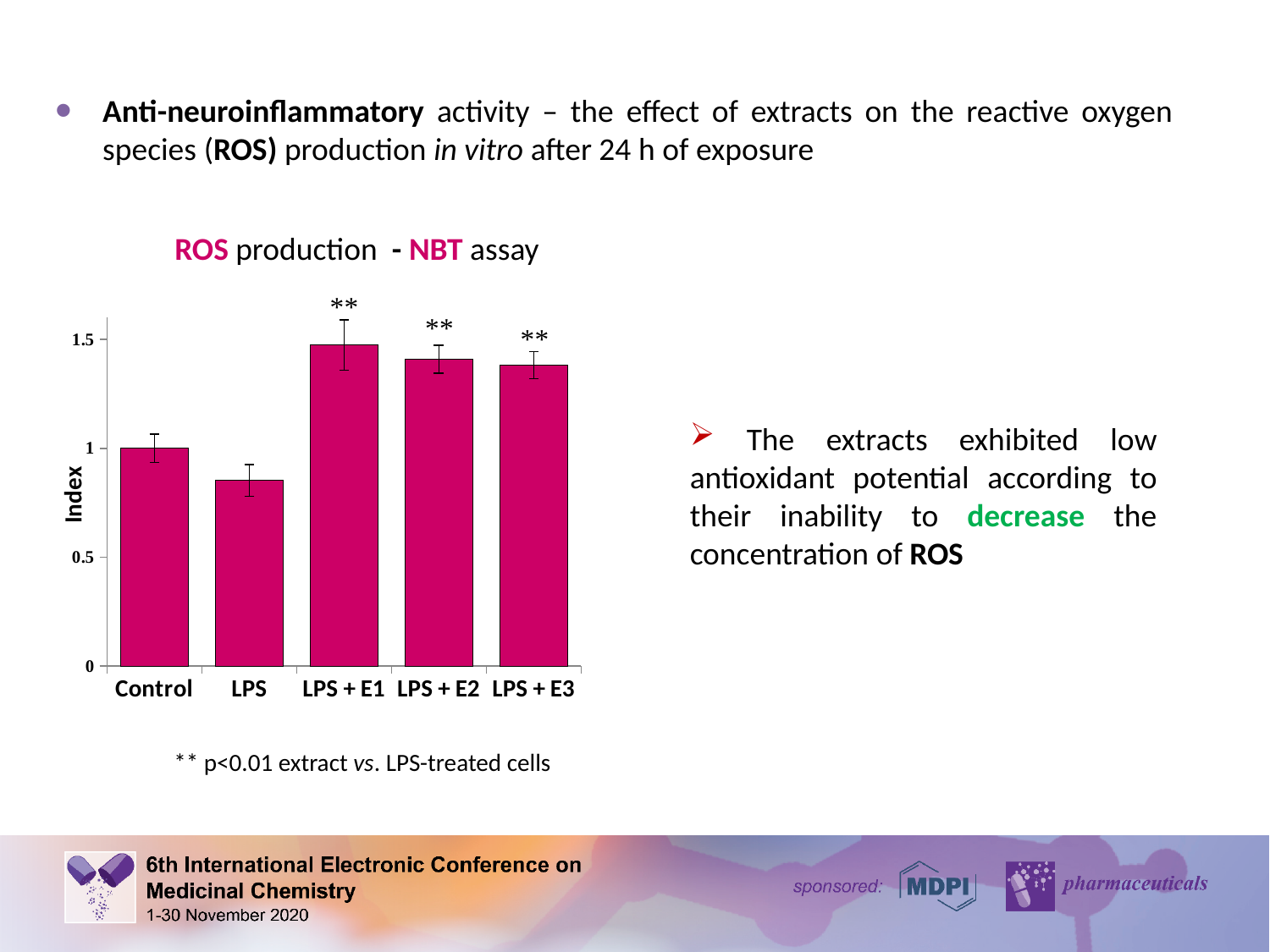
How many categories are shown on the x axis of the chart? 5 Is the value for LPS + E2 greater or less than 1? greater Which has the larger value, Control or LPS? Control Which category has the highest bar in the chart? LPS + E1 What is the label of the y axis of the chart? Index What is the Index value for Control? 1 What kind of chart is shown on the slide? bar chart Is the value for LPS + E3 greater or less than 1.5? less What is the title of the chart? ROS production - NBT assay Which category has the lowest bar in the chart? LPS Which has the larger value, LPS or LPS + E1? LPS + E1 Is the value for LPS greater or less than 1? less